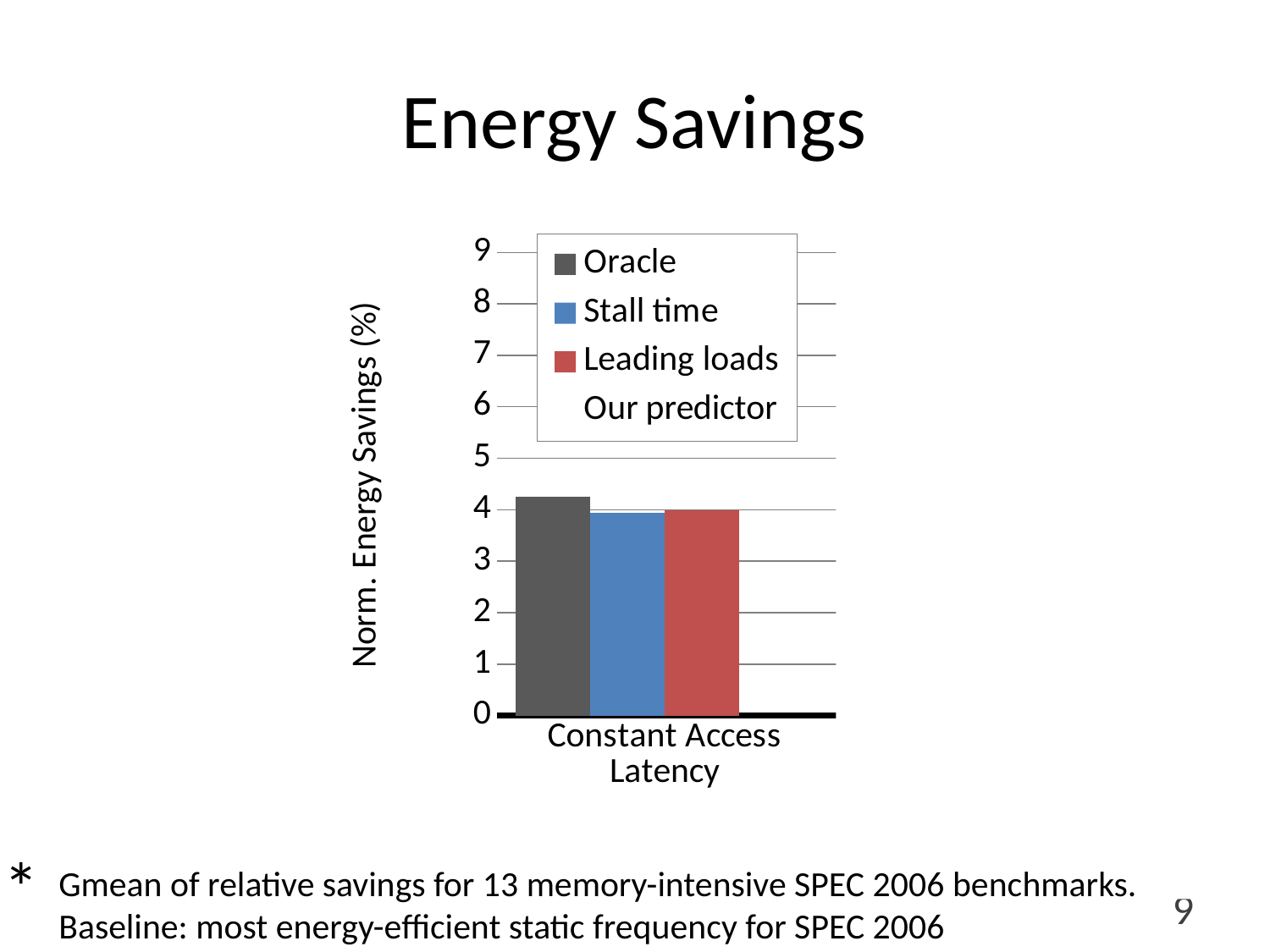
Is the value for Stall time greater or less than 3? greater Which series has the highest bar for Constant Access Latency? Oracle Is the value for Leading loads greater or less than 5? less How many series does the legend list? 4 What is the label of the y axis? Norm. Energy Savings (%) What is the category label on the x axis? Constant Access Latency How many categories are shown on the x axis? 1 Is the value for Oracle greater or less than 5? less Which is larger, the value for Oracle or the value for Stall time? Oracle What kind of chart is shown on the slide? bar chart